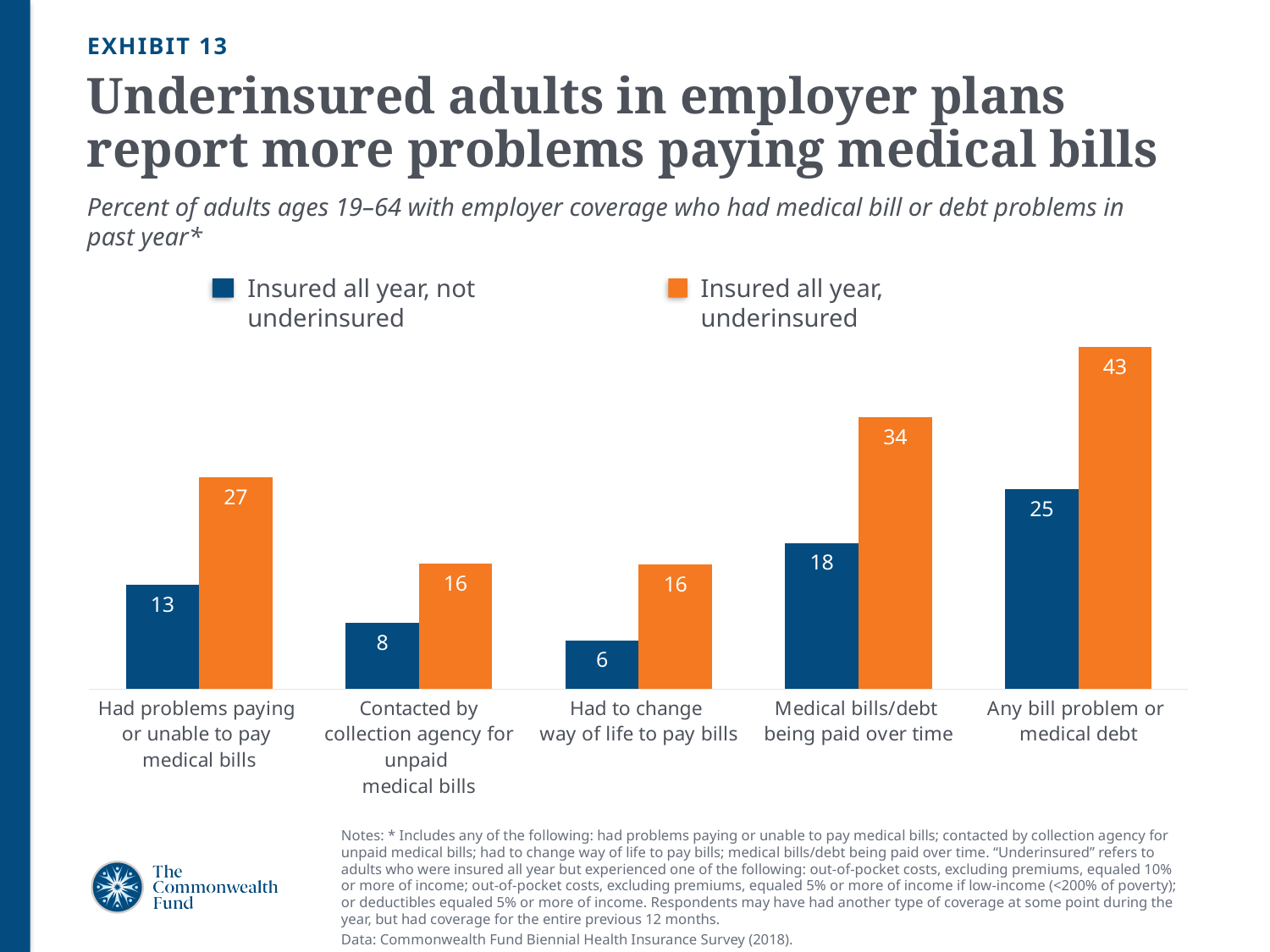
What kind of chart is shown on the slide? Bar chart What colour represents the 'Insured all year, underinsured' series? Orange In the 'Medical bills/debt being paid over time' category, which series has the larger value? Insured all year, underinsured What is the value for 'Insured all year, not underinsured' in the 'Contacted by collection agency for unpaid medical bills' category? 8 What is the difference between the underinsured and not underinsured values in the 'Had problems paying or unable to pay medical bills' category? 14 Which category has the lowest value for the 'Insured all year, not underinsured' series? Had to change way of life to pay bills Which category has the highest value for the 'Insured all year, underinsured' series? Any bill problem or medical debt How many categories are shown on the x axis? 5 How many series does the legend list? 2 What is the difference between the underinsured and not underinsured values in the 'Any bill problem or medical debt' category? 18 What is the value for 'Insured all year, underinsured' in the 'Any bill problem or medical debt' category? 43 What is the value for 'Insured all year, underinsured' in the 'Medical bills/debt being paid over time' category? 34